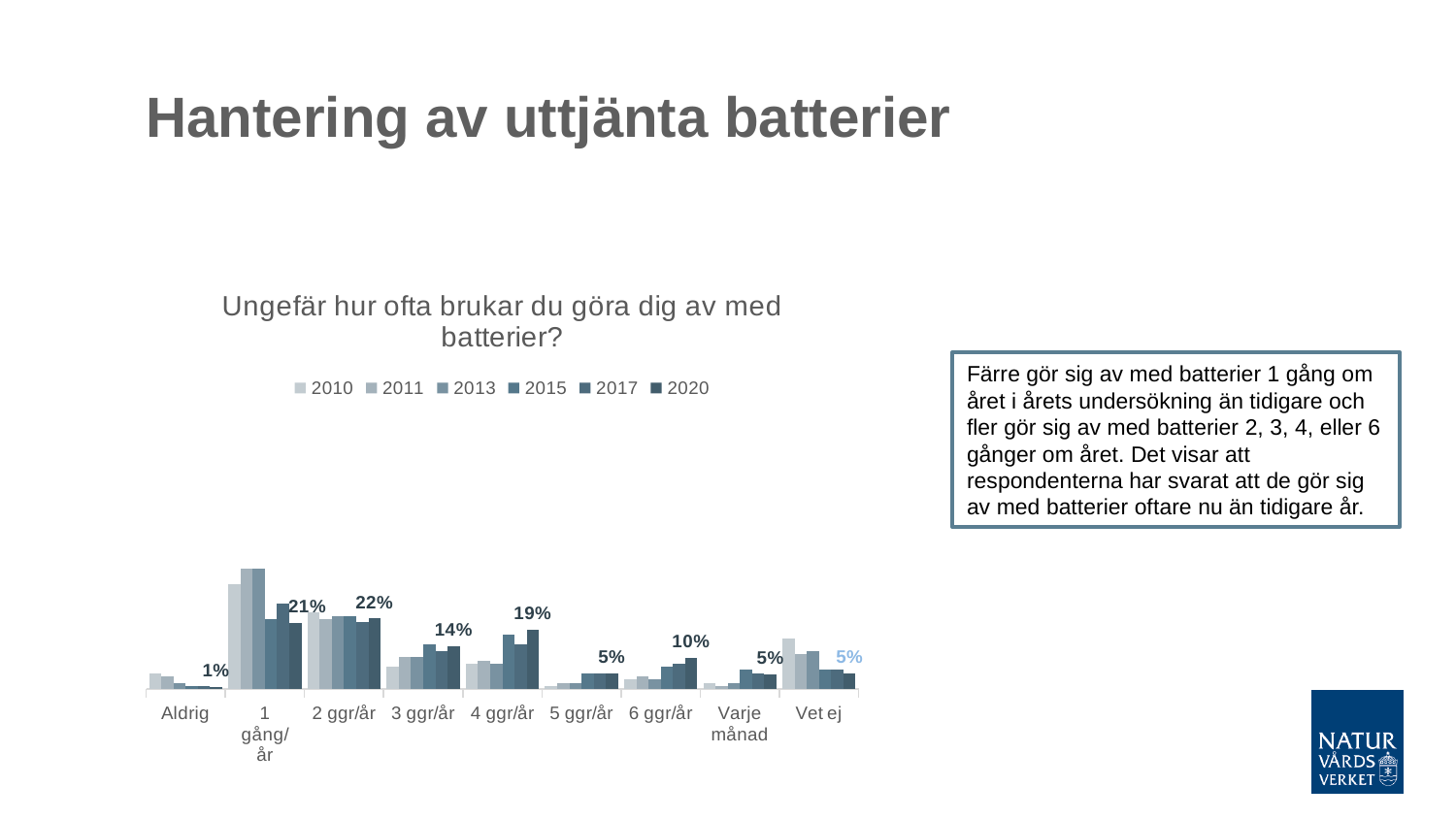
For 2020, which is larger: the value for '3 ggr/år' or the value for '4 ggr/år'? 4 ggr/år What is the title of the chart? Ungefär hur ofta brukar du göra dig av med batterier? What is the difference between the labelled 2020 values for '2 ggr/år' and '3 ggr/år'? 8 percentage points Among the labelled 2020 values, which category has the lowest value? Aldrig How many categories are shown along the x axis of the chart? 9 Among the labelled 2020 values, which category has the highest value? 2 ggr/år What is the labelled 2020 value for 'Aldrig'? 1% What is the labelled 2020 value for '4 ggr/år'? 19% What is the labelled 2020 value for '6 ggr/år'? 10% What is the labelled 2020 value for '2 ggr/år'? 22% How many series does the chart legend list? 6 What kind of chart is shown on the slide? Bar chart